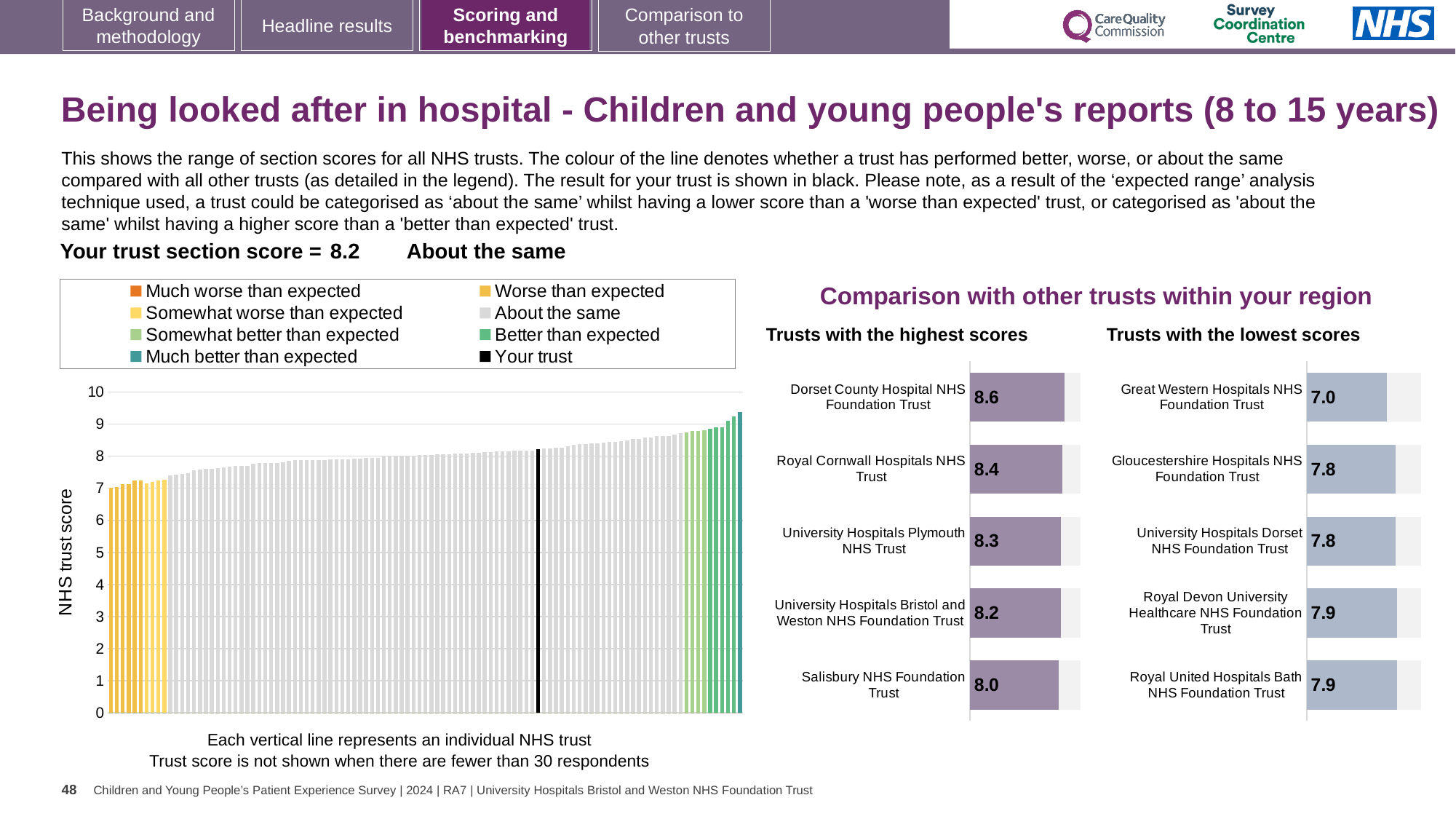
In the 'Trusts with the highest scores' chart, which has the larger score: Royal Cornwall Hospitals NHS Trust or University Hospitals Plymouth NHS Trust? Royal Cornwall Hospitals NHS Trust In the 'Trusts with the highest scores' chart, what is the score for Dorset County Hospital NHS Foundation Trust? 8.6 What kind of chart is the 'NHS trust score' chart on the left of the slide? Bar chart In the 'NHS trust score' chart on the left, do the values rise or fall from left to right? Rise In the 'Trusts with the lowest scores' chart, what is the difference between the scores of Royal United Hospitals Bath NHS Foundation Trust and Great Western Hospitals NHS Foundation Trust? 0.9 In the 'Trusts with the lowest scores' chart, what is the score for Great Western Hospitals NHS Foundation Trust? 7.0 How many trusts are listed in the 'Trusts with the lowest scores' chart? 5 How many entries does the legend of the 'NHS trust score' chart list? 8 In the 'Trusts with the highest scores' chart, which trust has the highest score? Dorset County Hospital NHS Foundation Trust In the 'Trusts with the highest scores' chart, what is the difference between the scores of Dorset County Hospital NHS Foundation Trust and Salisbury NHS Foundation Trust? 0.6 In the 'Trusts with the lowest scores' chart, which trust has the lowest score? Great Western Hospitals NHS Foundation Trust In the 'Trusts with the highest scores' chart, what is the score for Salisbury NHS Foundation Trust? 8.0